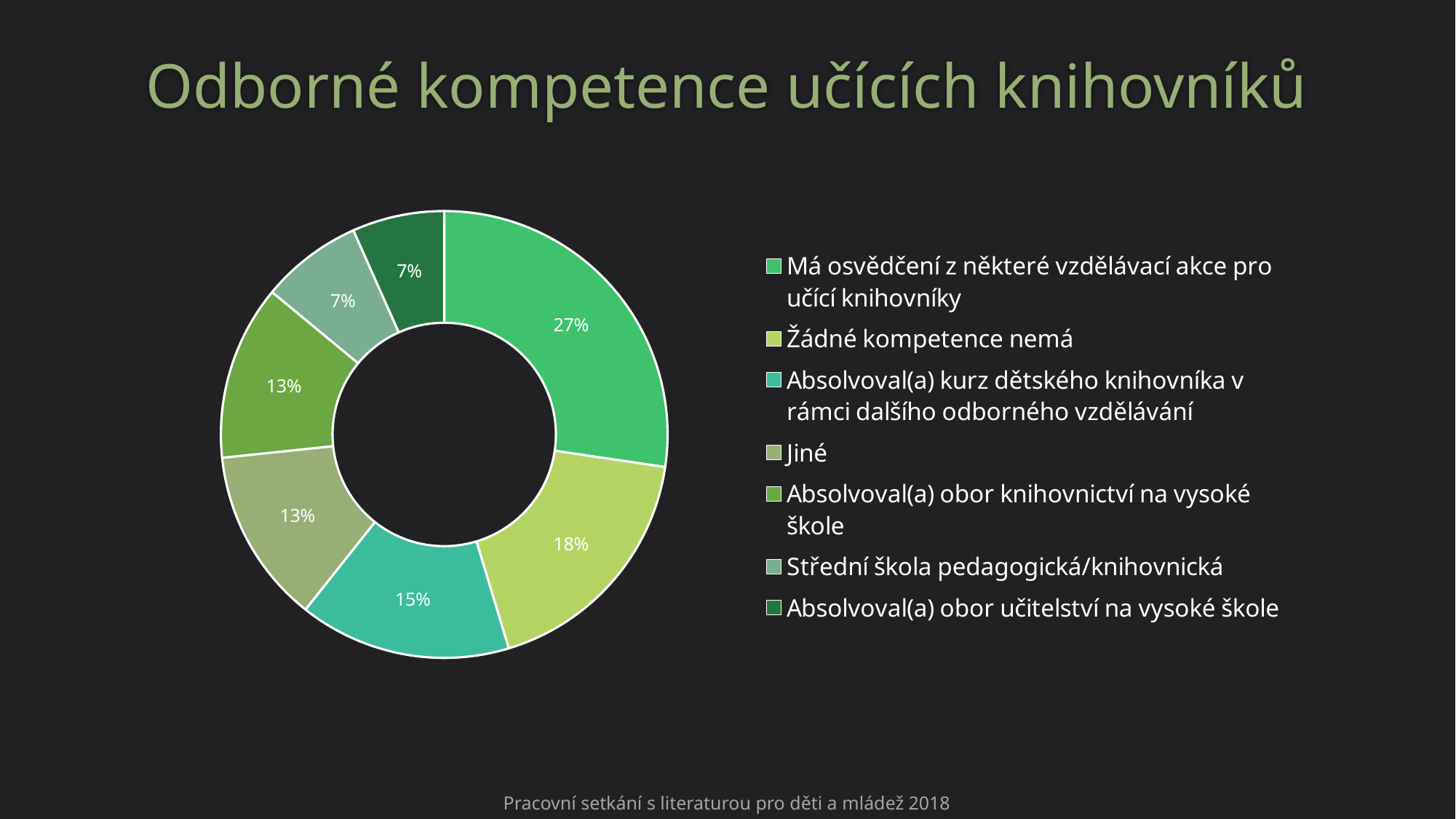
Which is larger: the share for 'Absolvoval(a) kurz dětského knihovníka v rámci dalšího odborného vzdělávání' or the share for 'Absolvoval(a) obor knihovnictví na vysoké škole'? Absolvoval(a) kurz dětského knihovníka v rámci dalšího odborného vzdělávání What percentage is shown for 'Jiné'? 13% Which category has the largest share of the pie? Má osvědčení z některé vzdělávací akce pro učící knihovníky What percentage is shown for 'Žádné kompetence nemá'? 18% What percentage is shown for 'Absolvoval(a) kurz dětského knihovníka v rámci dalšího odborného vzdělávání'? 15% What percentage of the pie is labelled for 'Má osvědčení z některé vzdělávací akce pro učící knihovníky'? 27% What share of the pie does 'Absolvoval(a) obor učitelství na vysoké škole' represent? 7% How many categories does the pie chart have? 7 What type of chart is shown on the slide? Pie chart (doughnut) What is the title of the chart on the slide? Odborné kompetence učících knihovníků What is the difference in percentage points between 'Má osvědčení z některé vzdělávací akce pro učící knihovníky' and 'Žádné kompetence nemá'? 9 percentage points What percentage is shown for 'Střední škola pedagogická/knihovnická'? 7%